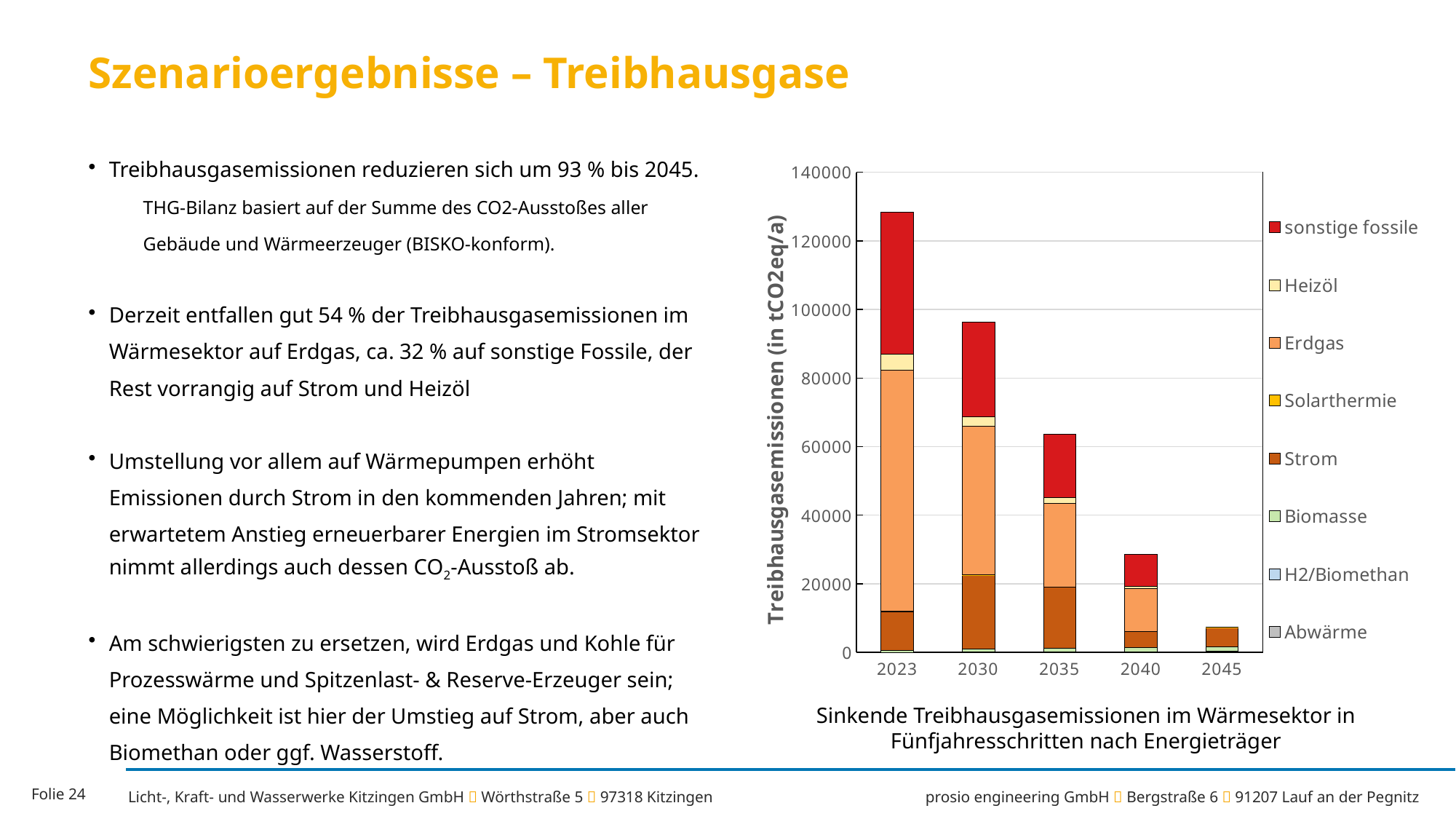
How many series does the chart legend list? 8 Which year has the highest total greenhouse gas emissions in the chart? 2023 Do the total emissions rise or fall from 2023 to 2045 in the chart? Fall What kind of chart is shown on the slide? Stacked bar chart Which year has the larger total emissions, 2030 or 2035? 2030 Is the total bar for 2040 greater or less than 40000? less Is the total bar for 2045 greater or less than 20000? less How many years are shown on the x axis of the chart? 5 Is the total bar for 2030 greater or less than 100000? less What is the label of the y axis of the chart? Treibhausgasemissionen (in tCO2eq/a) Which year has the lowest total greenhouse gas emissions in the chart? 2045